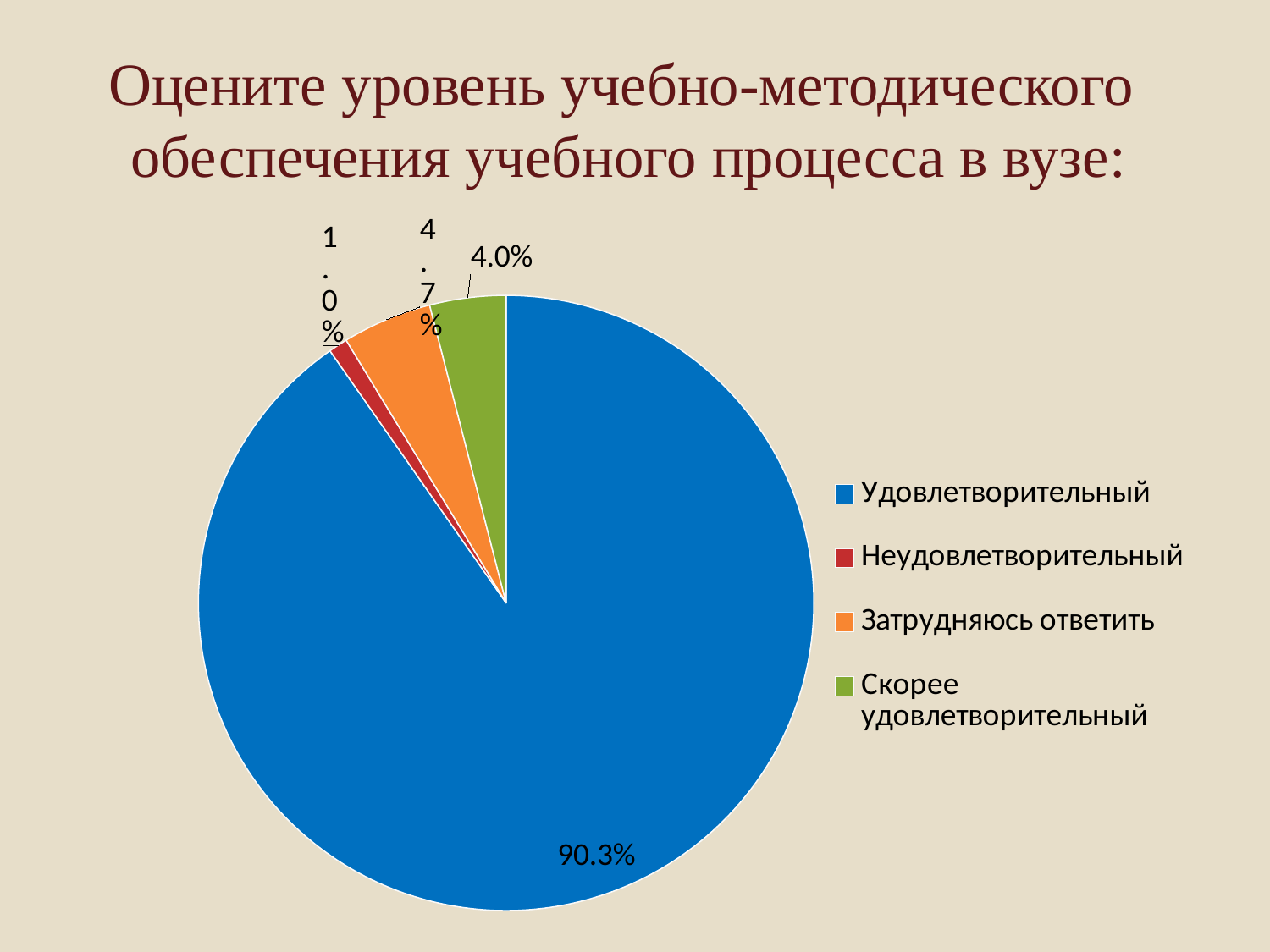
What type of chart is shown on the slide? pie chart What colour is the slice for "Скорее удовлетворительный"? green What percentage of respondents answered "Скорее удовлетворительный"? 4.0% What percentage of respondents answered "Затрудняюсь ответить"? 4.7% Which category has the smallest share of the pie? Неудовлетворительный Which category has the largest share of the pie? Удовлетворительный What is the difference in percentage points between "Удовлетворительный" and "Скорее удовлетворительный"? 86.3 What percentage of respondents answered "Удовлетворительный"? 90.3% What colour is the slice for "Затрудняюсь ответить"? orange Which is larger: the share for "Затрудняюсь ответить" or the share for "Неудовлетворительный"? Затрудняюсь ответить How many categories does the legend list? 4 What percentage of respondents answered "Неудовлетворительный"? 1.0%